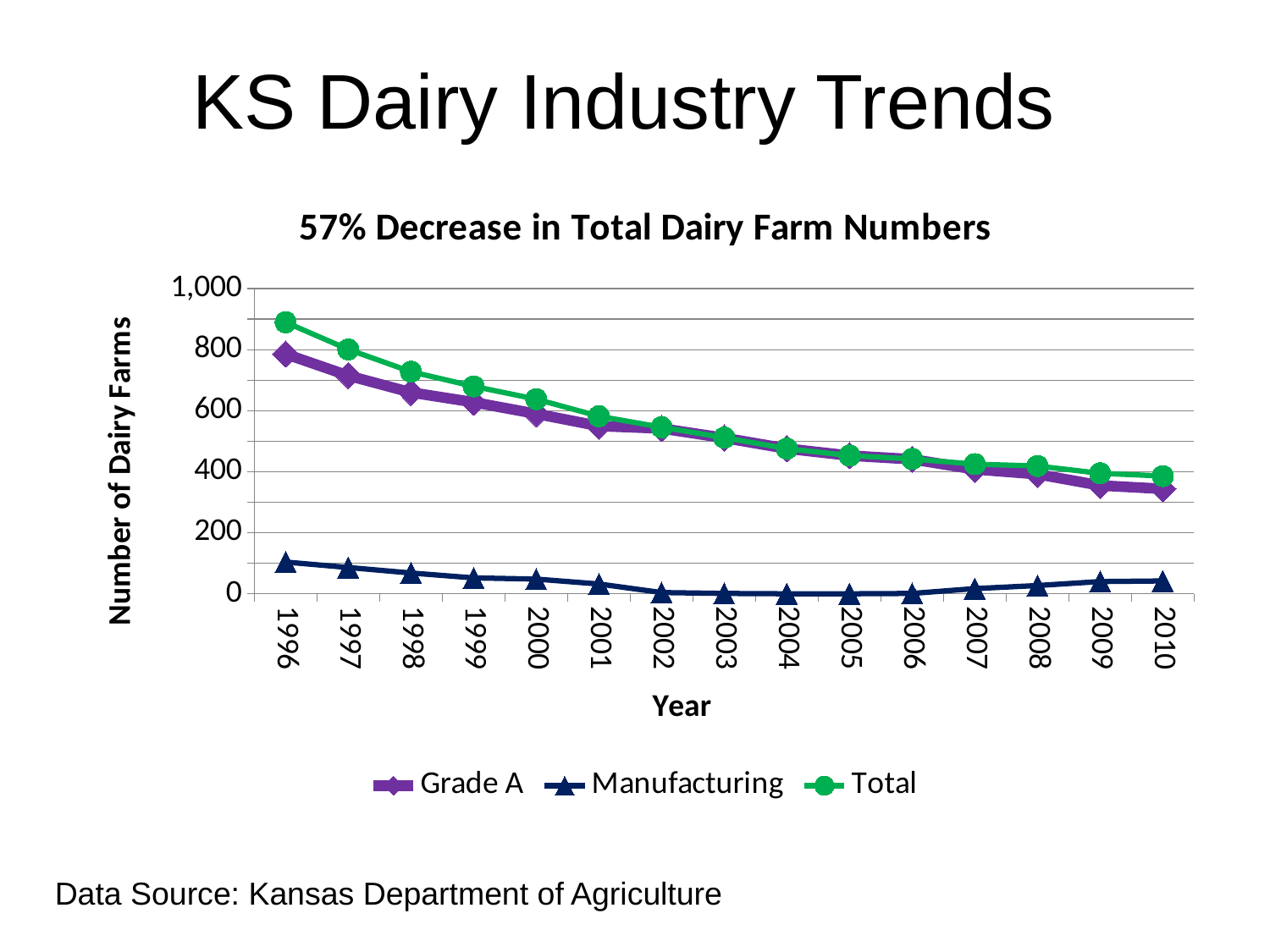
What is the title of the chart? 57% Decrease in Total Dairy Farm Numbers Is the Grade A value for 2010 greater or less than 400? less How many years are plotted along the x axis? 15 Is the Manufacturing value for 1996 greater or less than 200? less In which year is the Total series at its lowest? 2010 What is the label on the vertical axis? Number of Dairy Farms How many series does the legend list? 3 Which series has the larger value in 1996, Grade A or Manufacturing? Grade A Does the Total series rise or fall from 1996 to 2010? Fall In which year is the Total series at its highest? 1996 Is the Total value for 1996 greater or less than 800? greater What kind of chart is shown on the slide? Line chart